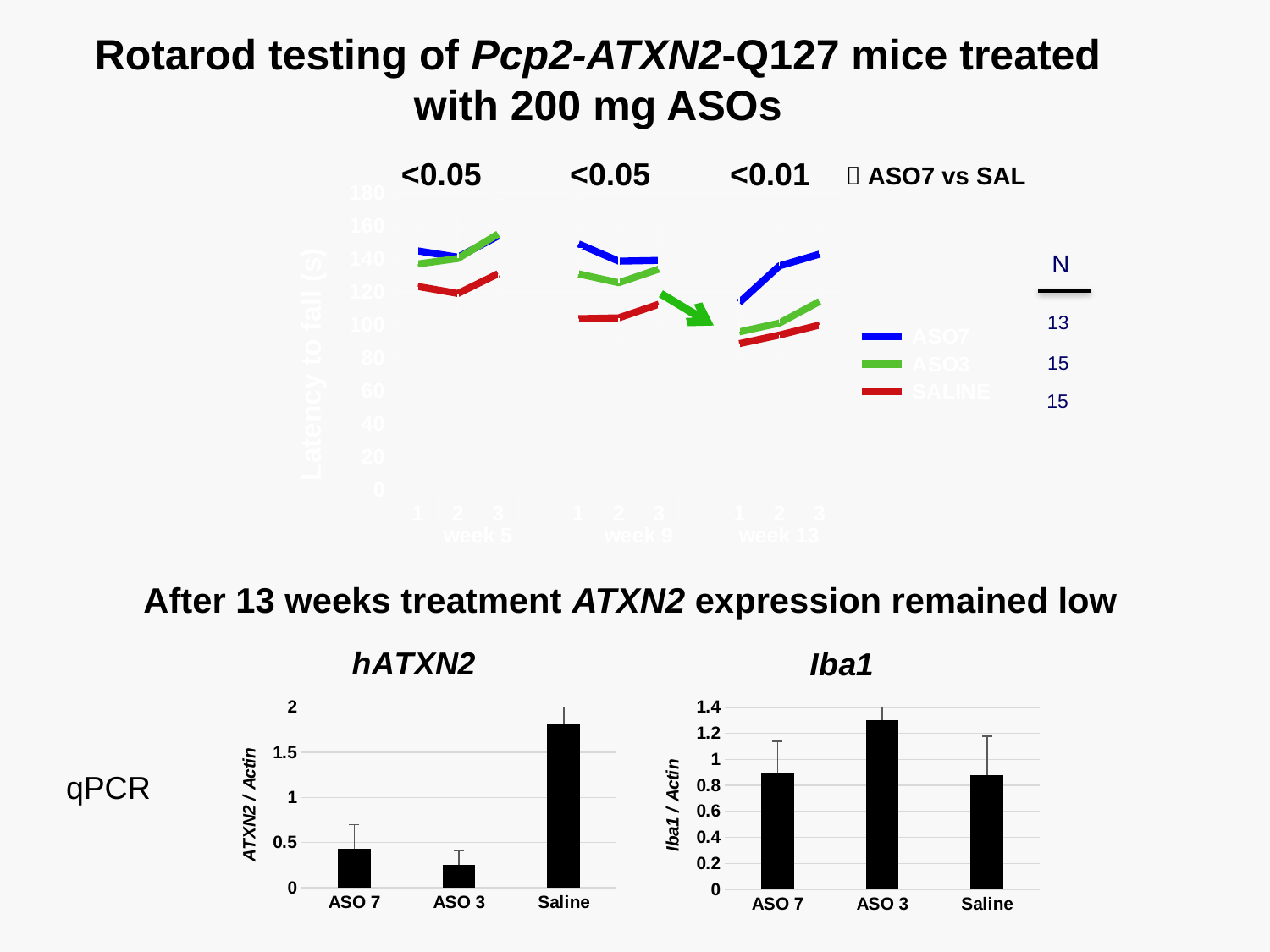
How many groups are plotted in the hATXN2 chart? 3 What kind of chart is the rotarod chart at the top of the slide? line chart In the hATXN2 chart, which group has the lowest ATXN2 / Actin value? ASO 3 In the hATXN2 chart, is the value for Saline greater or less than 1.5? greater In the Iba1 chart, which group has the highest Iba1 / Actin value? ASO 3 In the hATXN2 chart, which group has the highest ATXN2 / Actin value? Saline How many series does the legend of the rotarod chart at the top of the slide list? 3 What kind of chart is the hATXN2 chart? bar chart In the hATXN2 chart, is the value for ASO 3 greater or less than 0.5? less What is the y-axis label of the Iba1 chart? Iba1 / Actin In the Iba1 chart, is the value for ASO 3 greater or less than 1? greater In the Iba1 chart, which is larger, the value for ASO 3 or the value for ASO 7? ASO 3